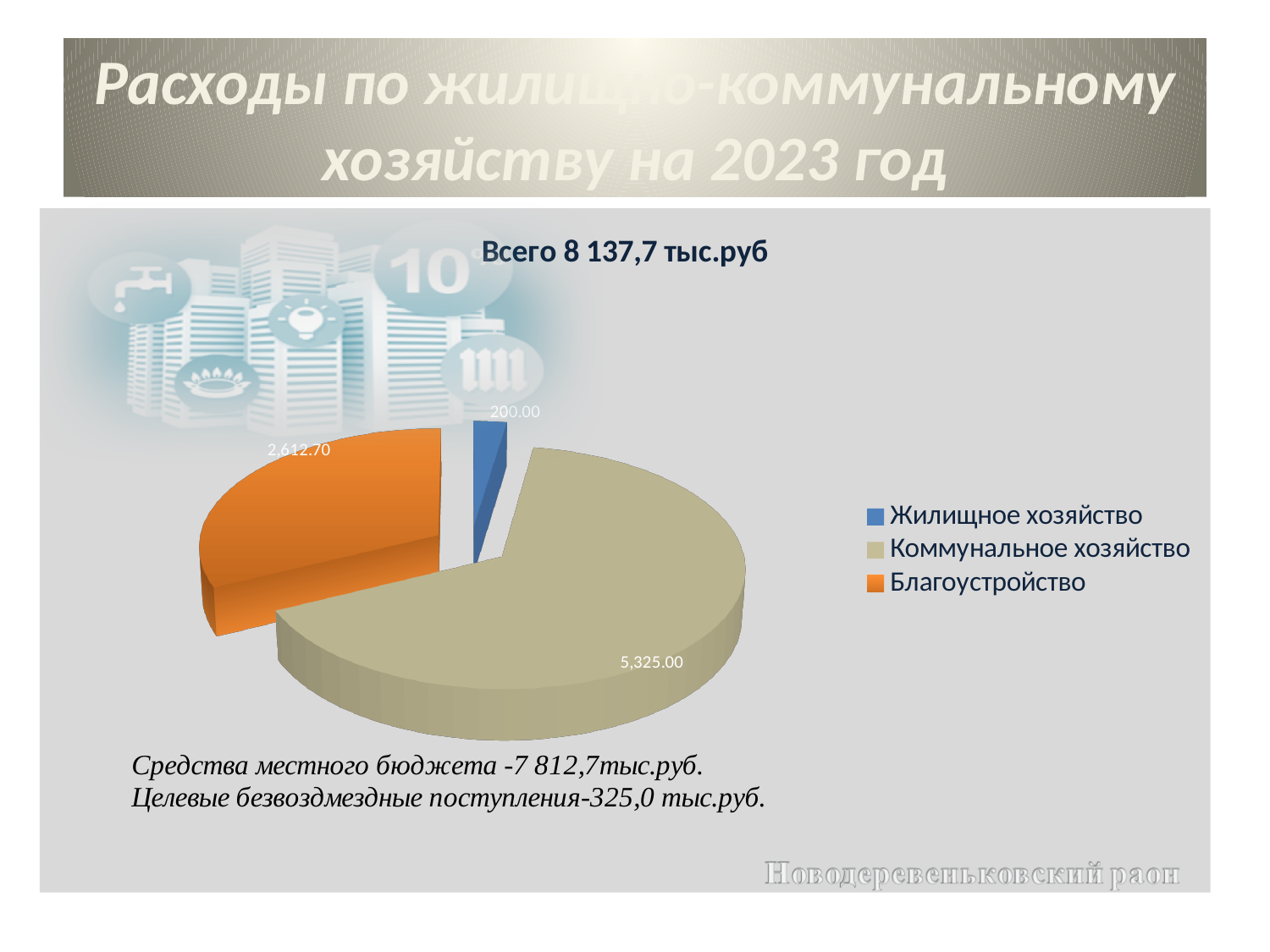
What total amount is stated in the chart title? 8 137,7 тыс.руб What is the value for Жилищное хозяйство? 200.00 What type of chart is shown on the slide? Pie chart What is the difference between the values for Коммунальное хозяйство and Благоустройство? 2,712.30 Which category has the smallest slice of the pie? Жилищное хозяйство What is the difference between the values for Благоустройство and Жилищное хозяйство? 2,412.70 What is the value for Коммунальное хозяйство? 5,325.00 What is the value for Благоустройство? 2,612.70 How many categories does the pie chart have? 3 Which is larger, the value for Благоустройство or the value for Жилищное хозяйство? Благоустройство What colour is the slice for Благоустройство? Orange Which category has the largest slice of the pie? Коммунальное хозяйство